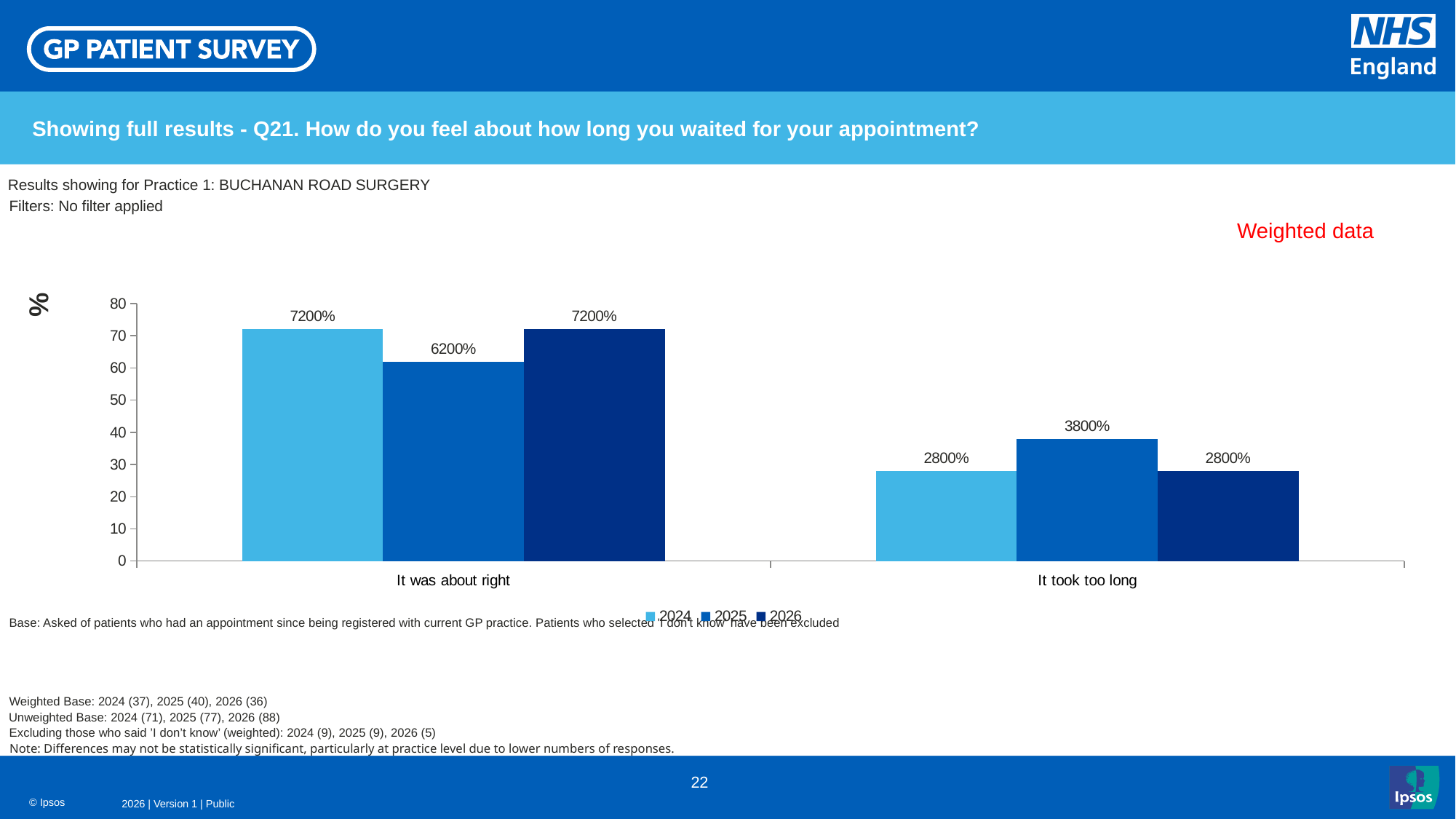
Is the 2025 bar for 'It took too long' greater or less than 30 on the axis? greater Which year has the highest bar in the 'It took too long' category? 2025 What is the data label for 2026 in the 'It took too long' category? 2800% For 2024, which category has the larger value: 'It was about right' or 'It took too long'? It was about right What is the data label for 2024 in the 'It was about right' category? 7200% How many series does the legend list? 3 What is the difference between the 2024 and 2025 data labels in the 'It was about right' category? 1000% Which year has the lowest bar in the 'It was about right' category? 2025 What is the data label for 2025 in the 'It was about right' category? 6200% What is the data label for 2025 in the 'It took too long' category? 3800% How many categories are shown on the x axis? 2 What kind of chart is shown on the slide? Bar chart